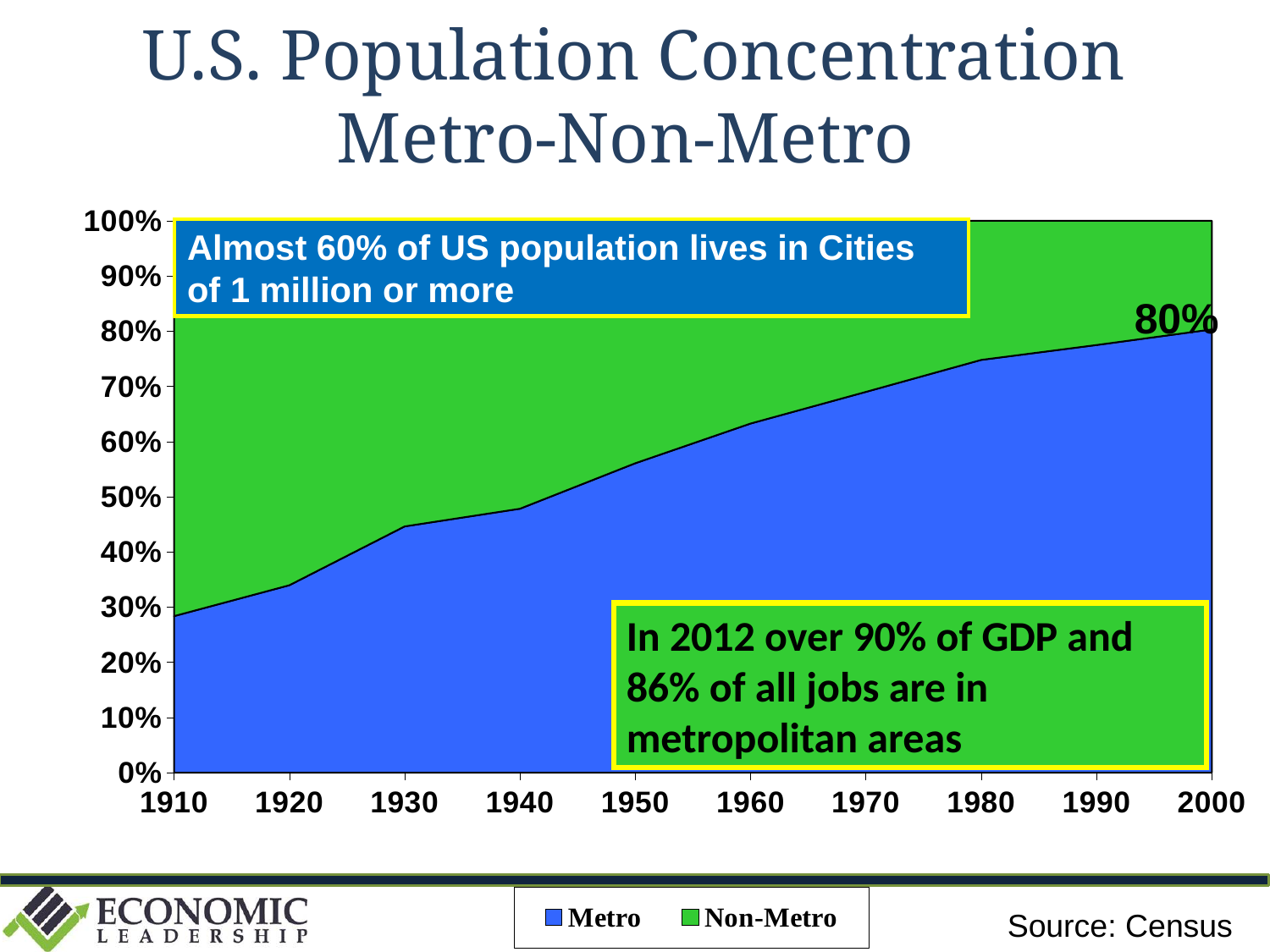
Which colour represents the Non-Metro series in the legend? green In which year is the Metro share highest? 2000 Is the Metro share in 1980 greater or less than 70%? greater What is the Metro share of the U.S. population in 2000? 80% In 2000, which is larger: the Metro share or the Non-Metro share? Metro Is the Metro share in 1910 greater or less than 40%? less How many series does the legend list? 2 In 1910, which is larger: the Metro share or the Non-Metro share? Non-Metro How many years are labelled along the x axis? 10 In which year is the Metro share lowest? 1910 Does the Metro share rise or fall from 1910 to 2000? rise What kind of chart is shown on the slide? area chart